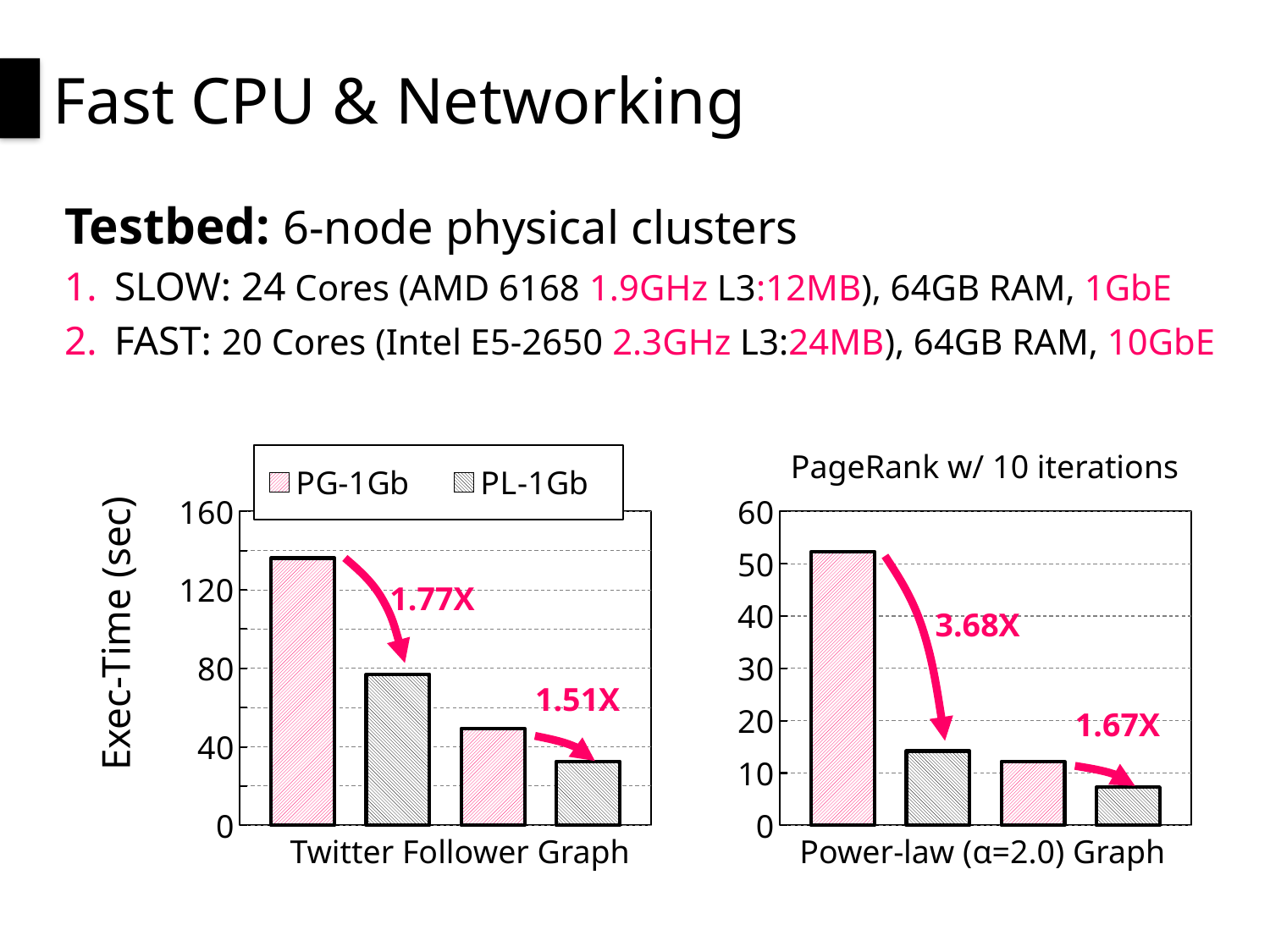
How many bars are plotted in the Twitter Follower Graph chart? 4 In the Twitter Follower Graph chart, is the value of the rightmost bar greater or less than 40? less In the Twitter Follower Graph chart, is the value of the PG-1Gb bar greater or less than 120? greater What speedup factor is annotated between the first two bars of the Power-law (α=2.0) Graph chart? 3.68X In the Power-law (α=2.0) Graph chart, is the value of the rightmost bar greater or less than 10? less In the Twitter Follower Graph chart, which bar is the tallest? PG-1Gb (the leftmost bar) How many bars are plotted in the Power-law (α=2.0) Graph chart? 4 How many series does the legend on the left chart list? 2 In the Power-law (α=2.0) Graph chart, which bar is the shortest? the rightmost bar In the Twitter Follower Graph chart, do the bar values rise or fall from left to right? fall What kind of chart is the Twitter Follower Graph chart on the left? bar chart